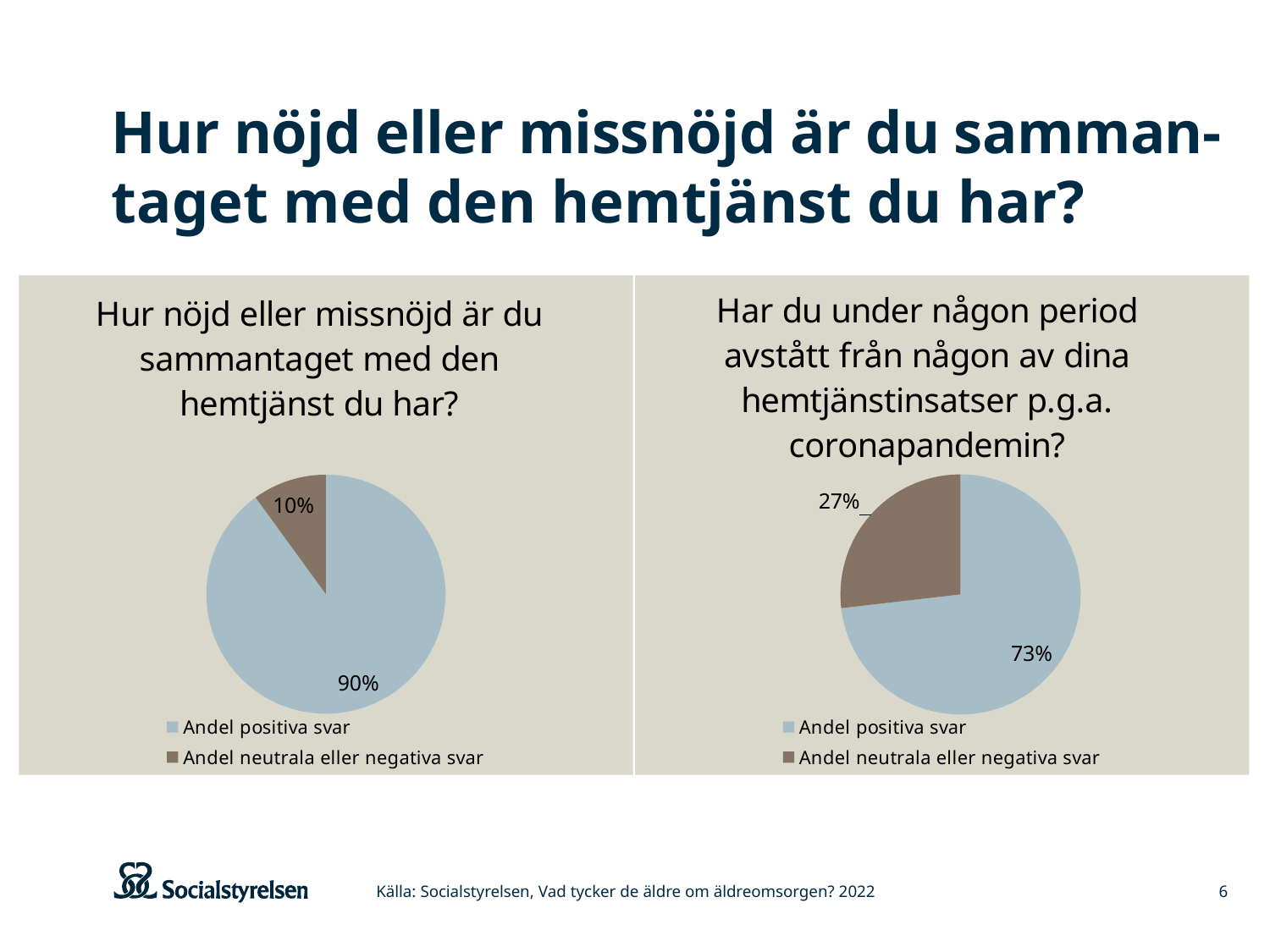
In the right pie chart ("Har du under någon period avstått från någon av dina hemtjänstinsatser p.g.a. coronapandemin?"), what is the value for Andel positiva svar? 73% In the left pie chart ("Hur nöjd eller missnöjd är du sammantaget med den hemtjänst du har?"), what is the value for Andel positiva svar? 90% How many entries does the legend of the right pie chart list? 2 How many pie charts are shown on the slide? 2 In the right pie chart, what is the value for Andel neutrala eller negativa svar? 27% In the left pie chart, what is the value for Andel neutrala eller negativa svar? 10% Is Andel positiva svar larger in the left pie chart or in the right pie chart? Left pie chart In the left pie chart, which slice is the largest? Andel positiva svar In the right pie chart, what is the difference between Andel positiva svar and Andel neutrala eller negativa svar? 46 percentage points In the left pie chart, what is the difference between Andel positiva svar and Andel neutrala eller negativa svar? 80 percentage points In the right pie chart, which slice is the smallest? Andel neutrala eller negativa svar What type of chart is used on the left side of the slide? Pie chart